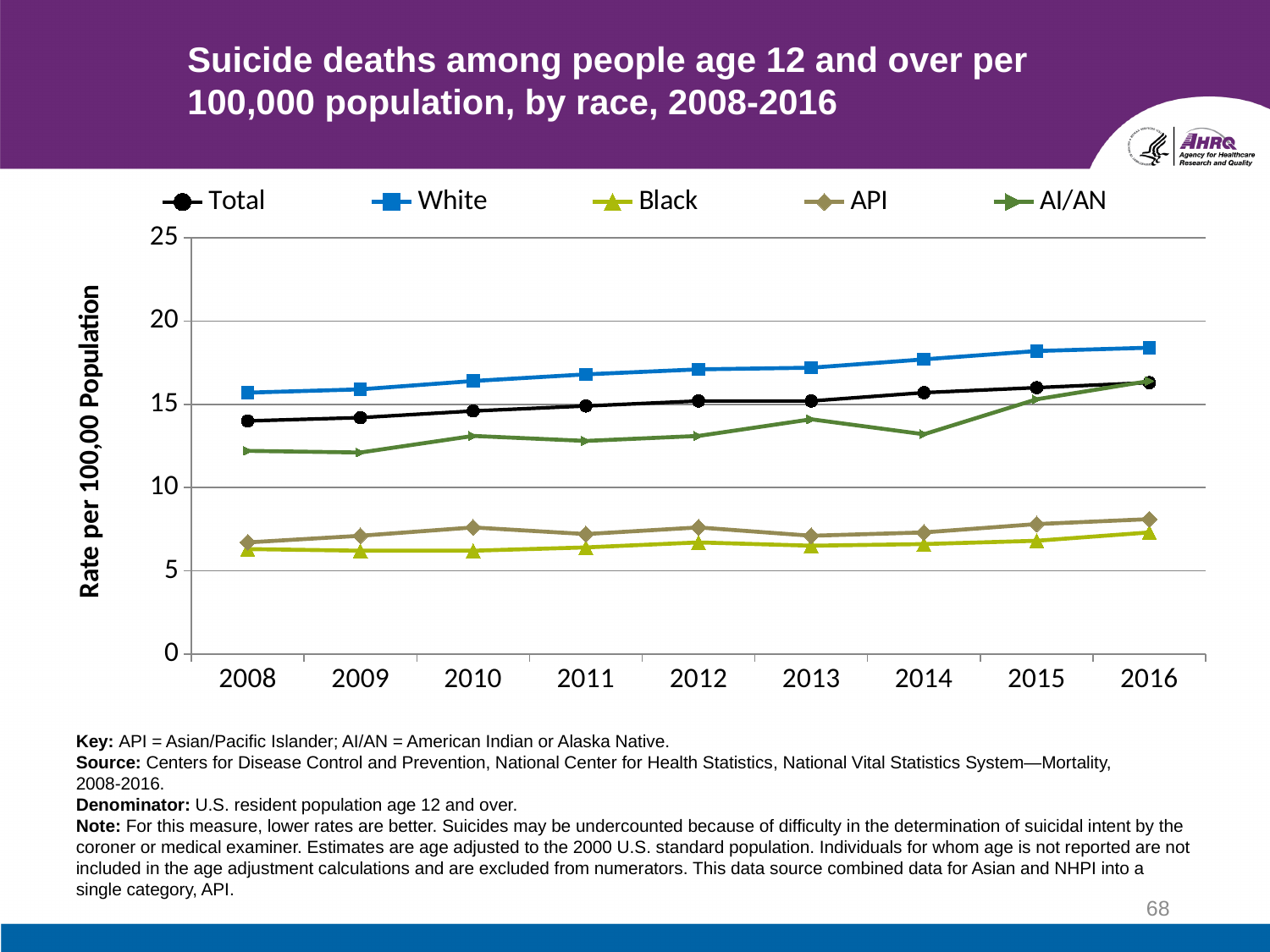
Is the value for White in 2008 greater or less than 15? greater Is the value for AI/AN in 2008 greater or less than 10? greater Is the value for White in 2016 greater or less than 20? less Which is larger in 2010, the rate for API or the rate for Black? API How many series does the legend list? 5 Does the rate for White rise or fall from 2008 to 2016? rise What kind of chart is shown on the slide? line chart What is the label of the y axis? Rate per 100,00 Population Which series has the lowest rate in 2008? Black Which series has the highest rate in 2016? White How many years are plotted along the x axis? 9